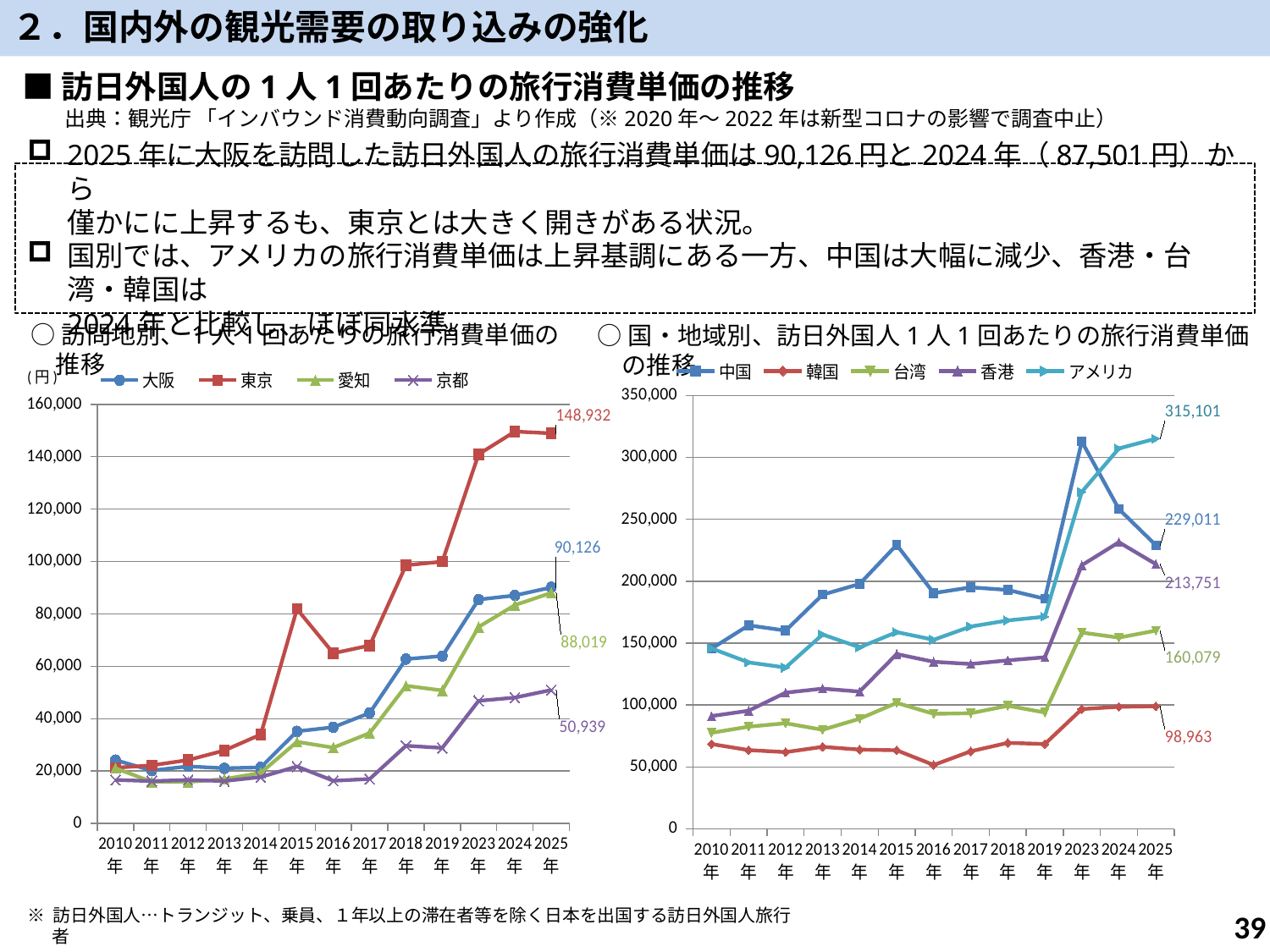
In the left chart (訪問地別), what is the value for 大阪 in 2025年? 90,126 In the right chart (国・地域別), how many years are plotted on the x axis? 13 In the left chart (訪問地別), is the value for 東京 in 2015年 greater or less than 60,000? greater In the left chart (訪問地別), what is the difference between the 2025年 values for 東京 and 大阪? 58,806 In the left chart (訪問地別), what is the value for 東京 in 2025年? 148,932 In the left chart (訪問地別), which series has the lowest value in 2025年? 京都 In the right chart (国・地域別), which is larger in 2025年, 中国 or 香港? 中国 In the right chart (国・地域別), which series has the highest value in 2025年? アメリカ What kind of chart is the right chart (国・地域別)? Line chart In the left chart (訪問地別), how many series does the legend list? 4 In the right chart (国・地域別), what is the value for アメリカ in 2025年? 315,101 In the right chart (国・地域別), what is the value for 韓国 in 2025年? 98,963